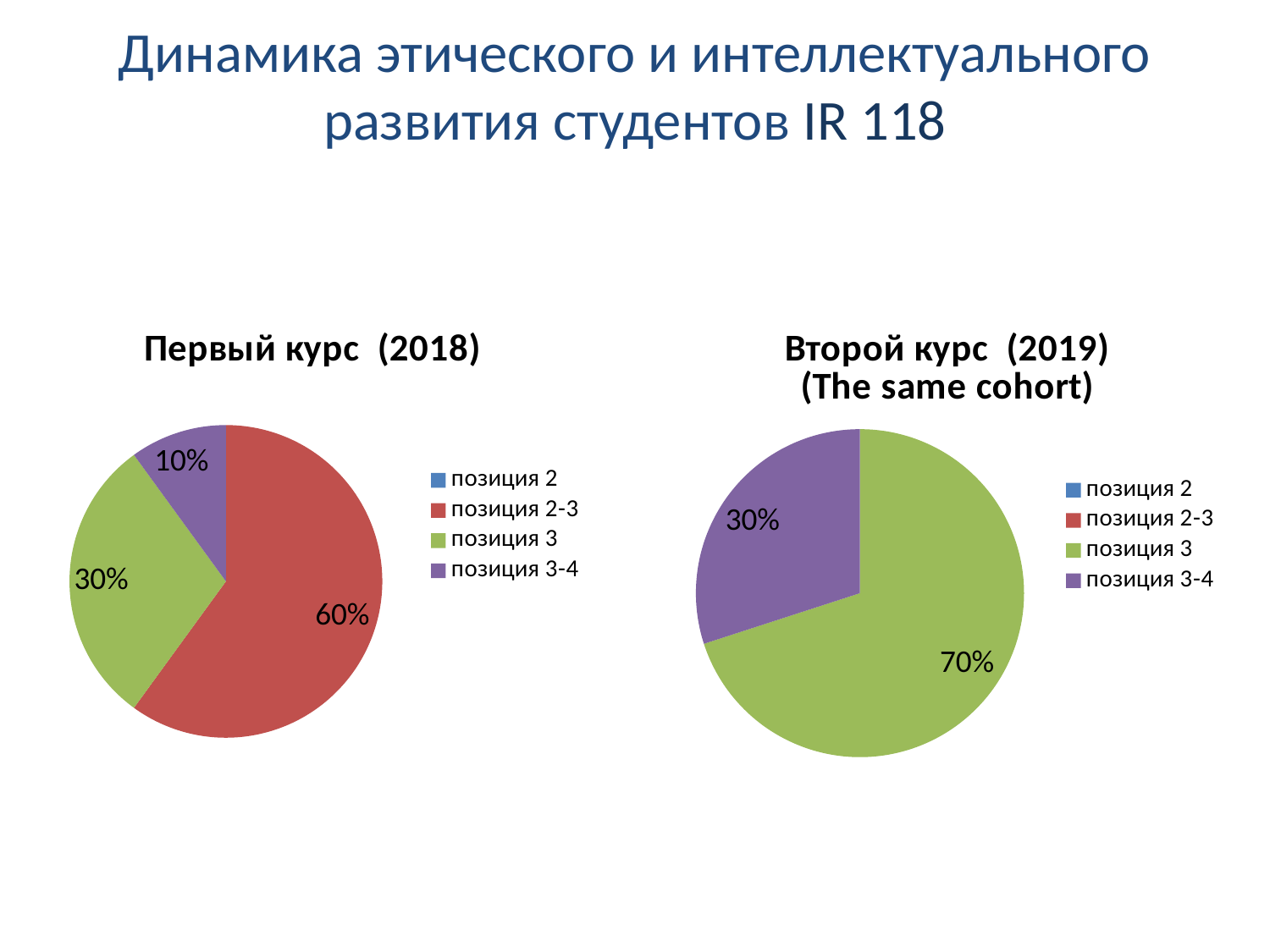
In the "Второй курс (2019)" chart, which category has the largest slice? позиция 3 What type of chart is used on the left of the slide? Pie chart In the "Второй курс (2019)" chart, what share does "позиция 3-4" have? 30% In the "Первый курс (2018)" chart, what share does "позиция 2-3" have? 60% In the "Второй курс (2019)" chart, what is the difference between the shares of "позиция 3" and "позиция 3-4"? 40% In the "Второй курс (2019)" chart, what share does "позиция 3" have? 70% How many entries does the legend of the "Второй курс (2019)" chart list? 4 In the "Первый курс (2018)" chart, which visible slice is the smallest? позиция 3-4 In the "Первый курс (2018)" chart, what is the difference between the shares of "позиция 2-3" and "позиция 3"? 30% In the "Первый курс (2018)" chart, which category has the largest slice? позиция 2-3 In the "Первый курс (2018)" chart, what share does "позиция 3-4" have? 10% In the "Первый курс (2018)" chart, which is larger: "позиция 3" or "позиция 3-4"? позиция 3